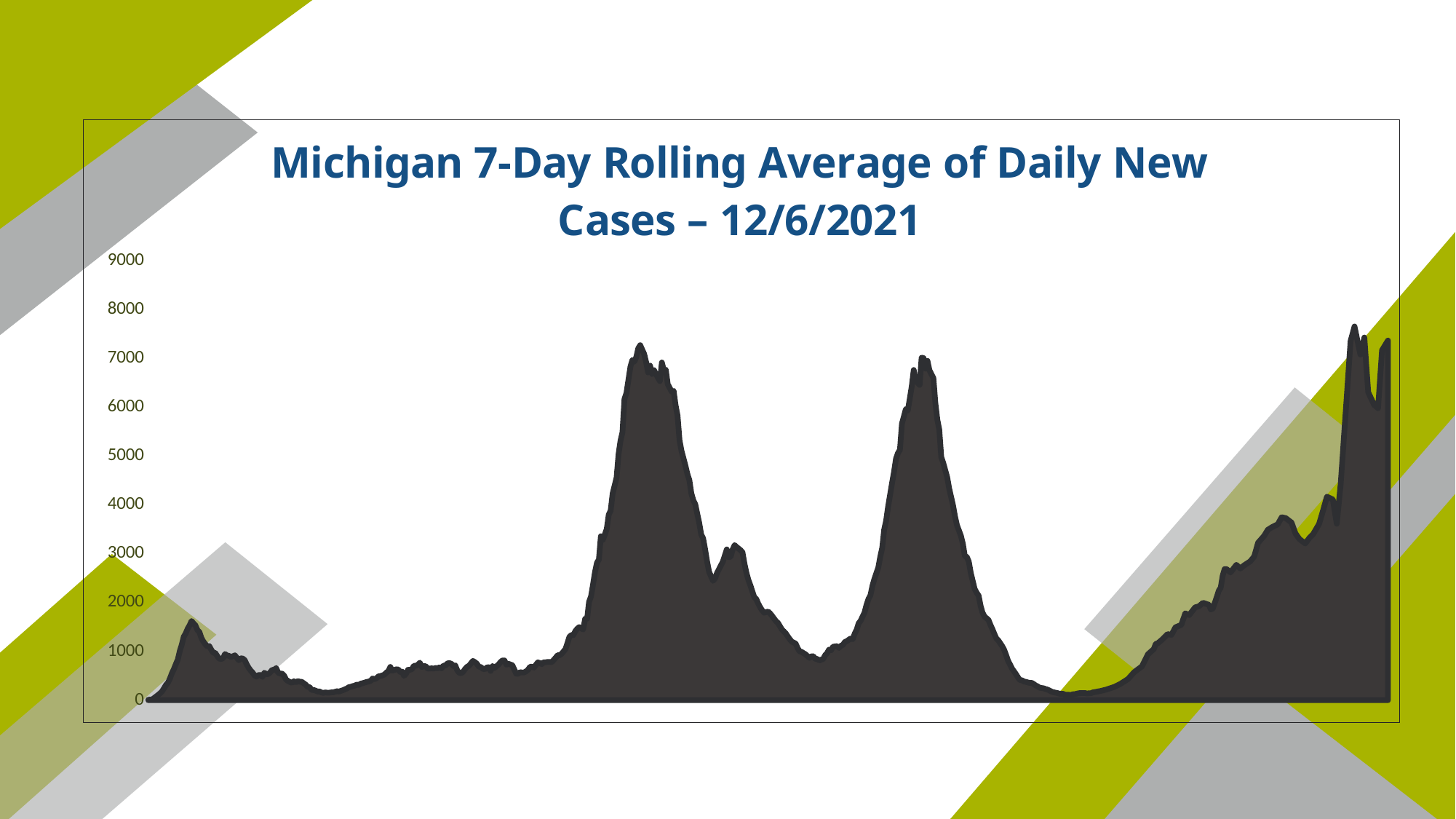
Is the highest value reached on the chart greater or less than 8000? less Is the value at the far right end of the chart higher or lower than the value at the far left end? higher What is the highest value shown on the vertical axis? 9000 Is the value at the far right end of the chart greater or less than 6000? greater What is the title of the chart? Michigan 7-Day Rolling Average of Daily New Cases – 12/6/2021 What kind of chart is shown on the slide? area chart Is the first (leftmost) peak on the chart greater or less than 2000? less